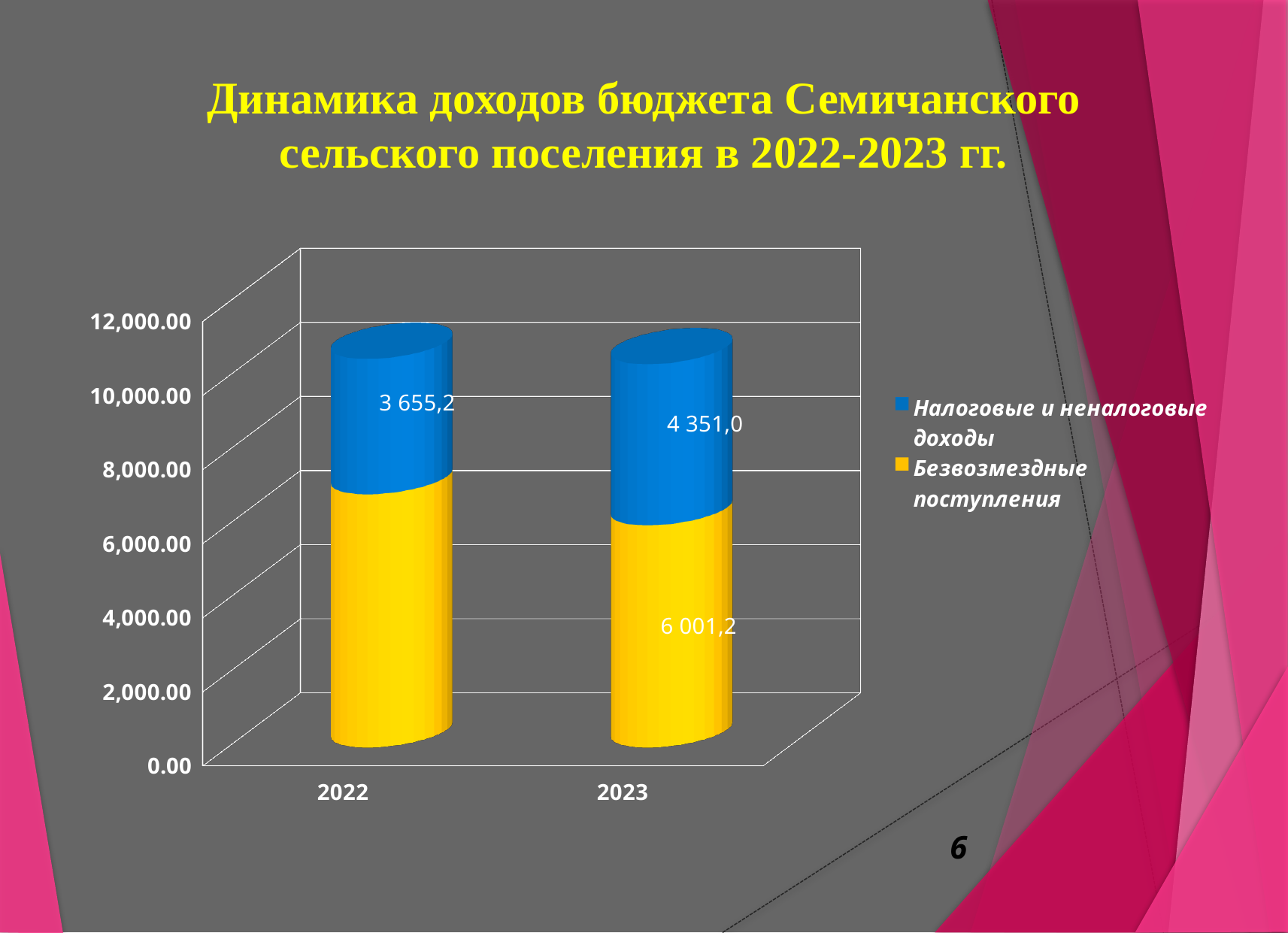
What is the value of Налоговые и неналоговые доходы for 2022? 3 655,2 What kind of chart is shown on the slide? stacked bar chart What is the total of the stacked bar for 2023 based on the printed labels? 10 352,2 How many years (categories) are shown on the x axis? 2 Which year has the larger value for Налоговые и неналоговые доходы, 2022 or 2023? 2023 Do the values for Налоговые и неналоговые доходы rise or fall from 2022 to 2023? rise What is the value of Налоговые и неналоговые доходы for 2023? 4 351,0 What is the value of Безвозмездные поступления for 2023? 6 001,2 How many series does the legend list? 2 By how much did Налоговые и неналоговые доходы change from 2022 to 2023? 695,8 Which colour represents Безвозмездные поступления in the legend? yellow Is the value of Безвозмездные поступления for 2022 greater or less than 4,000.00? greater